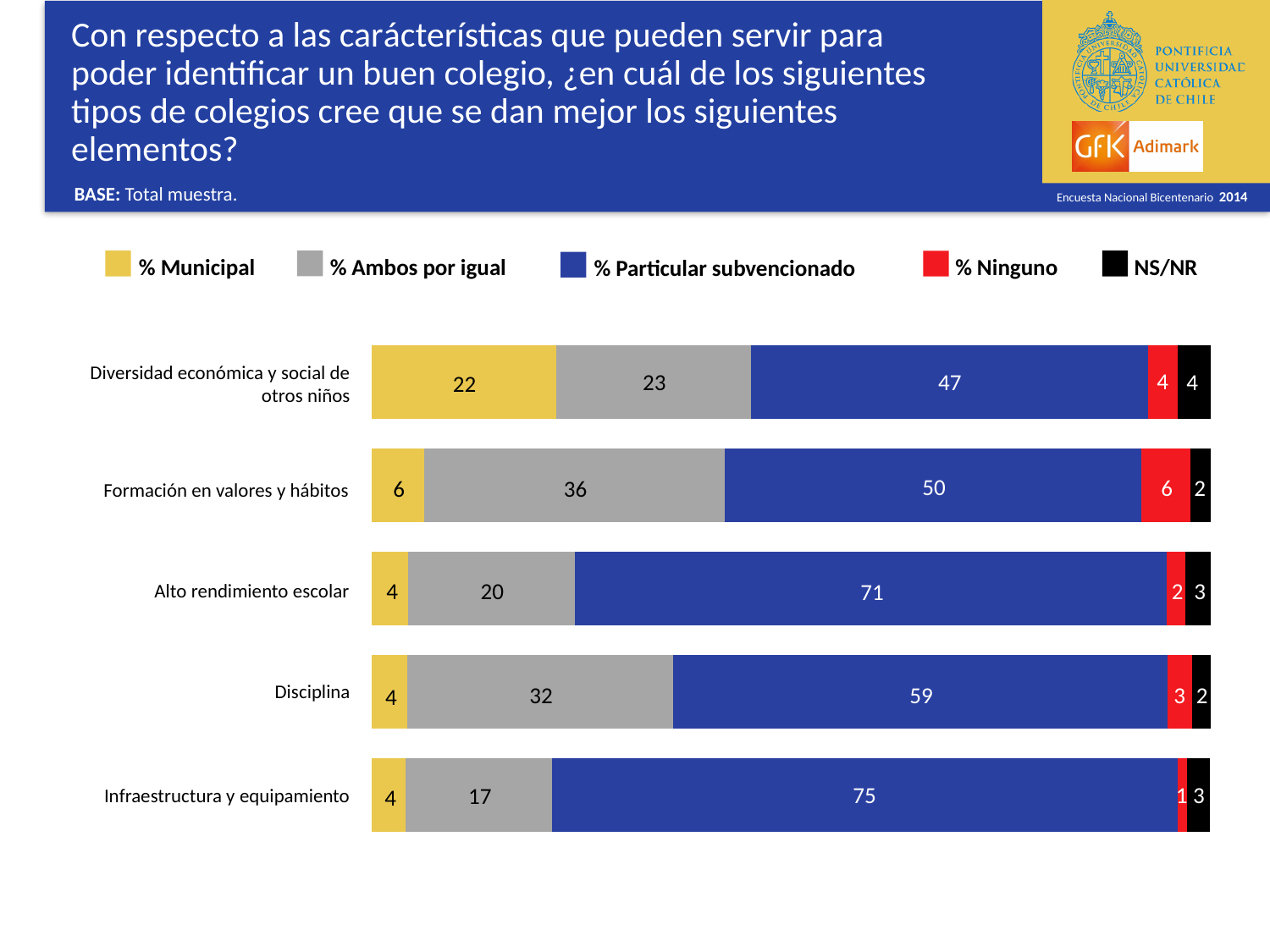
Which category has the lowest value for % Particular subvencionado? Diversidad económica y social de otros niños What is the difference between the % Particular subvencionado values for Infraestructura y equipamiento and Disciplina? 16 What is the total of the stacked bar for Formación en valores y hábitos? 100 Which category has the highest value for % Particular subvencionado? Infraestructura y equipamiento What is the value for % Particular subvencionado in the category Alto rendimiento escolar? 71 How many series does the legend list? 5 What type of chart is shown on the slide? Stacked bar chart What is the value for % Ambos por igual in the category Formación en valores y hábitos? 36 How many categories are plotted on the chart? 5 What is the value for % Municipal in the category Diversidad económica y social de otros niños? 22 Which legend entry is shown in red? % Ninguno Which is larger: the % Ambos por igual value for Disciplina or for Alto rendimiento escolar? Disciplina